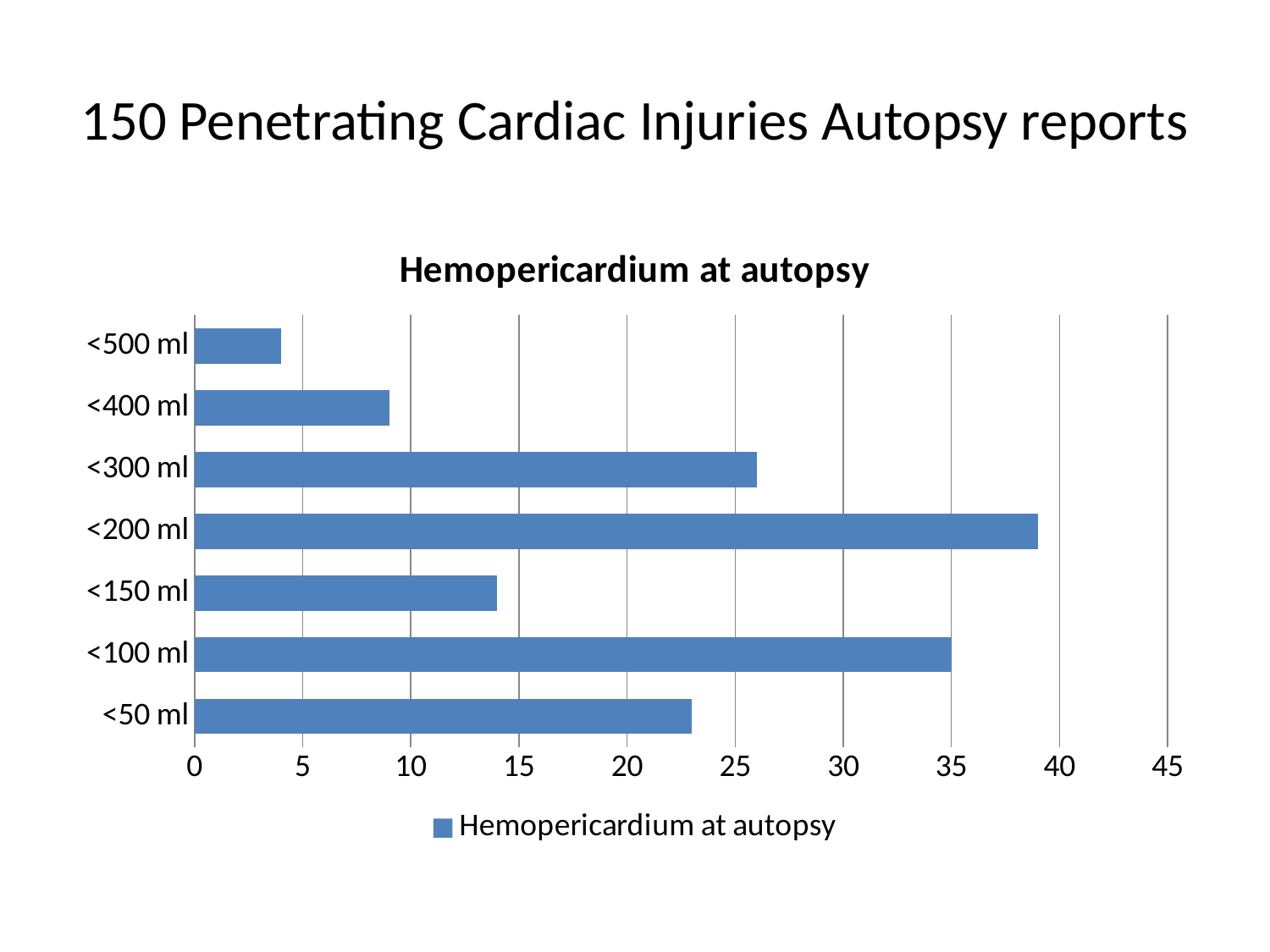
Which category has the lowest value? <500 ml Which is larger, the value for <100 ml or the value for <150 ml? <100 ml How many categories are plotted in the chart? 7 Which category has the highest value? <200 ml Is the value for <500 ml greater or less than 5? less Which is larger, the value for <400 ml or the value for <50 ml? <50 ml How many series does the legend list? 1 Is the value for <300 ml greater or less than 25? greater What is the title of the chart? Hemopericardium at autopsy Is the value for <150 ml greater or less than 15? less What type of chart is shown on the slide? bar chart